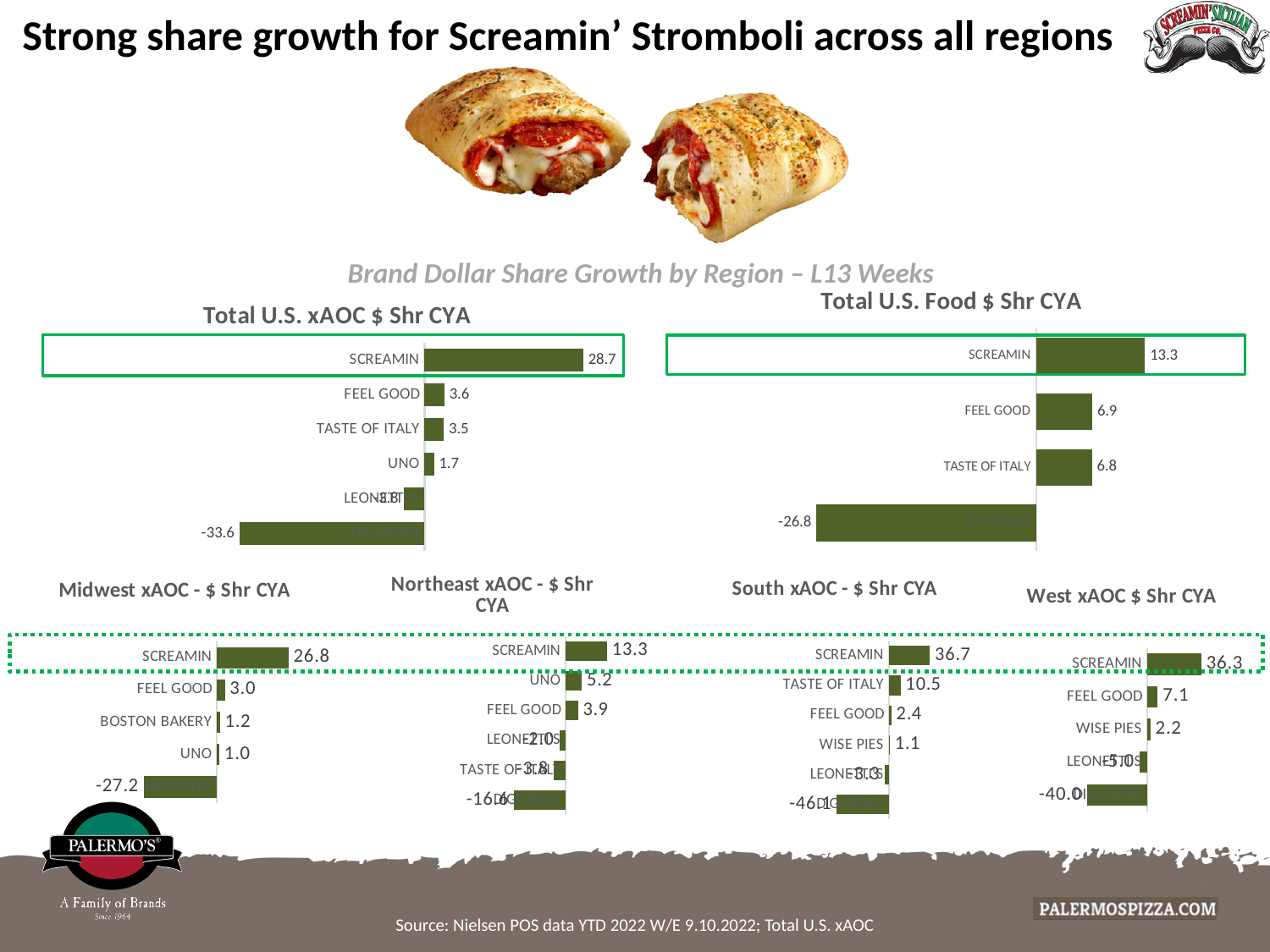
What type of chart is the Total U.S. xAOC $ Shr CYA chart? Bar chart In the Total U.S. Food $ Shr CYA chart, what is the value for FEEL GOOD? 6.9 In the Total U.S. xAOC $ Shr CYA chart, what is the difference between FEEL GOOD and TASTE OF ITALY? 0.1 In the South xAOC - $ Shr CYA chart, what is the value for TASTE OF ITALY? 10.5 In the Total U.S. xAOC $ Shr CYA chart, what is the value for UNO? 1.7 In the West xAOC $ Shr CYA chart, what is the value for WISE PIES? 2.2 In the Midwest xAOC - $ Shr CYA chart, which is larger, FEEL GOOD or UNO? FEEL GOOD In the South xAOC - $ Shr CYA chart, what is the difference between SCREAMIN and TASTE OF ITALY? 26.2 In the Total U.S. Food $ Shr CYA chart, which brand has the highest value? SCREAMIN In the Midwest xAOC - $ Shr CYA chart, what is the value for BOSTON BAKERY? 1.2 In the Total U.S. xAOC $ Shr CYA chart, what is the value for SCREAMIN? 28.7 In the Northeast xAOC - $ Shr CYA chart, what is the value for UNO? 5.2